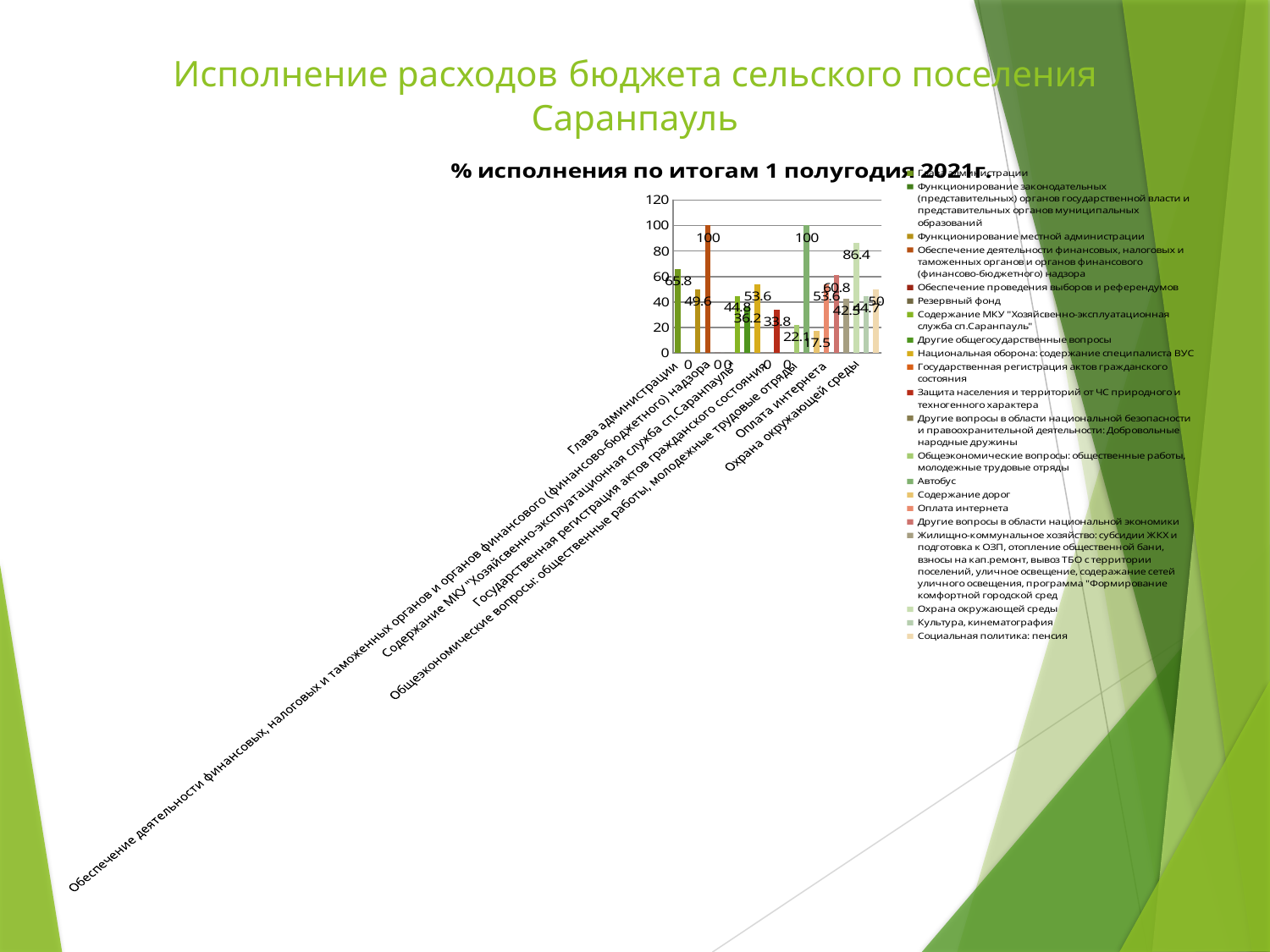
What is the value for Автобус? 100 What is the value for Охрана окружающей среды? 86.4 What is the difference between the value for Охрана окружающей среды (86.4) and the value for Глава администрации (65.8)? 20.6 What is the value for Глава администрации? 65.8 What is the value for Оплата интернета? 53.6 What is the value for Социальная политика: пенсия? 50 Which is larger, the value for Охрана окружающей среды or the value for Оплата интернета? Охрана окружающей среды Is the value for Охрана окружающей среды greater or less than 80? greater What kind of chart is shown on the slide? bar chart What is the title of the chart? % исполнения по итогам 1 полугодия 2021г. What is the highest value shown on the chart? 100 What is the maximum value shown on the vertical axis? 120